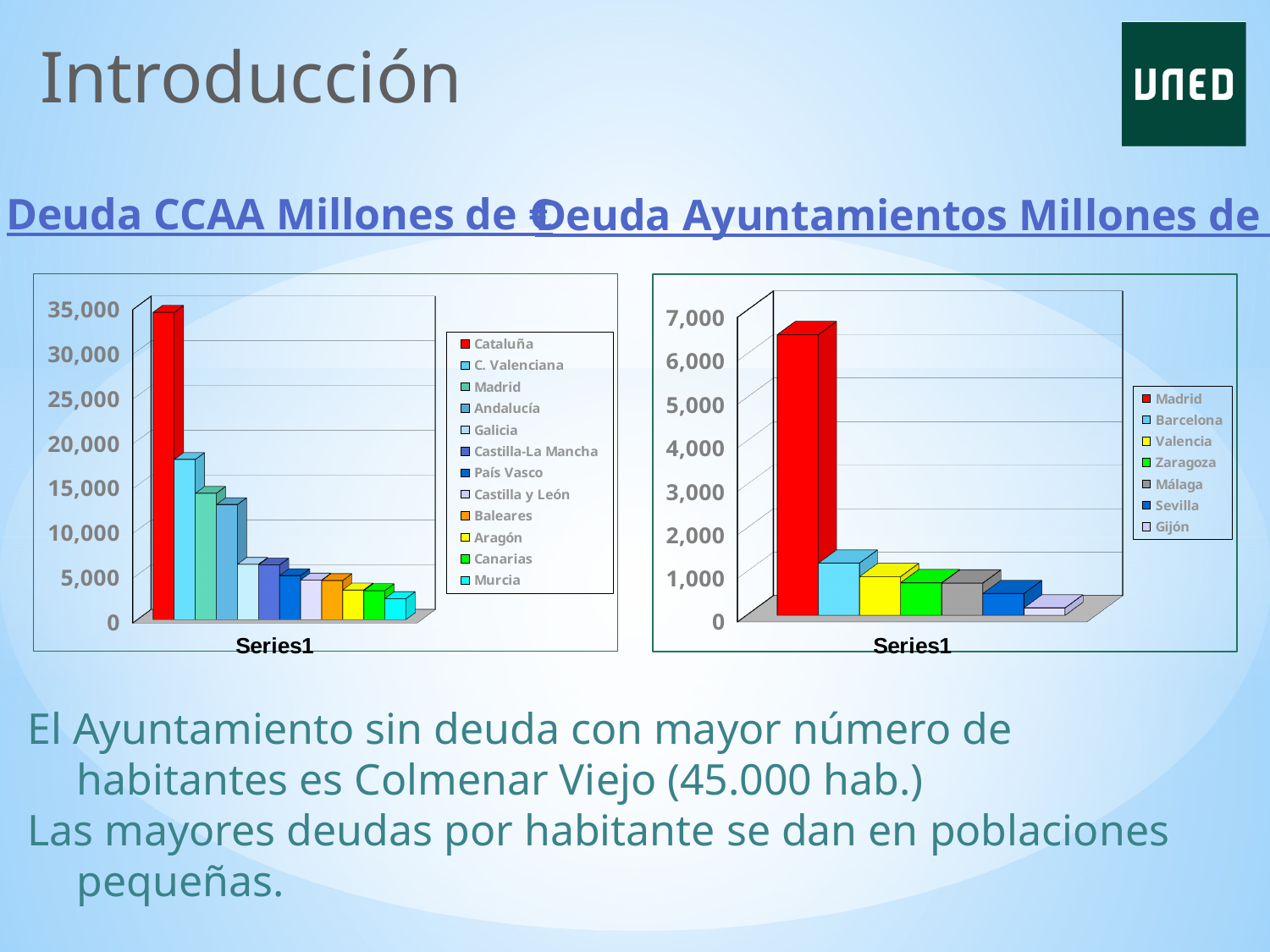
In the right chart (Deuda Ayuntamientos), which city has the highest debt? Madrid In the left chart (Deuda CCAA), which region has the highest debt? Cataluña In the right chart (Deuda Ayuntamientos), is the value for Sevilla greater or less than 1,000? less How many entries does the legend of the right chart (Deuda Ayuntamientos) list? 7 In the left chart (Deuda CCAA), is the value for Cataluña greater or less than 30,000? greater In the left chart (Deuda CCAA), which region has the lowest debt? Murcia In the right chart (Deuda Ayuntamientos), which city has the lowest debt? Gijón In the left chart (Deuda CCAA), which has a larger debt, Cataluña or C. Valenciana? Cataluña In the right chart (Deuda Ayuntamientos), is the value for Madrid greater or less than 6,000? greater How many entries does the legend of the left chart (Deuda CCAA) list? 12 What kind of chart is the right chart (Deuda Ayuntamientos)? Bar chart